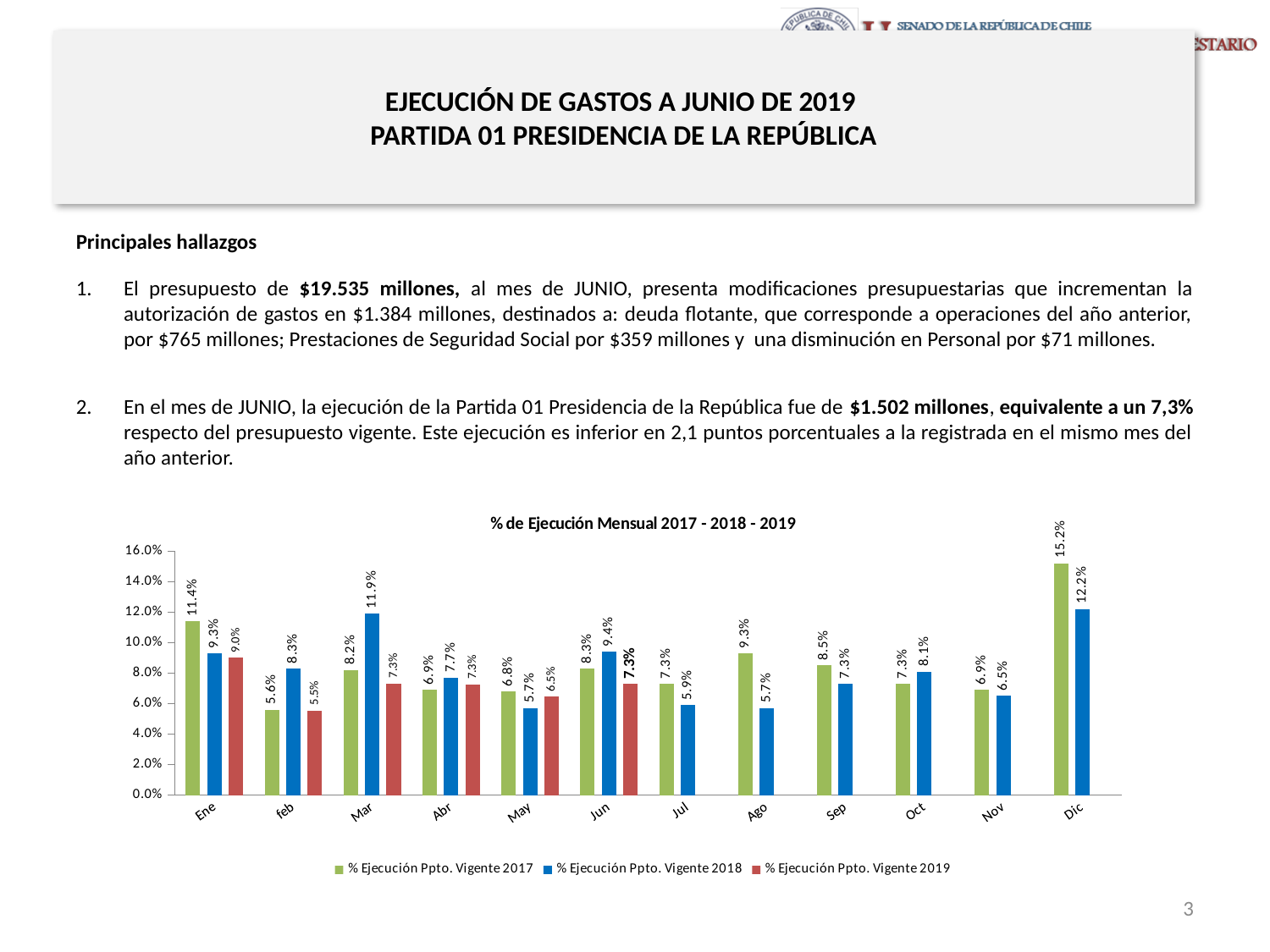
What is the value for % Ejecución Ppto. Vigente 2018 in Mar? 11.9% What is the difference between the 2017 and 2018 values in Ene? 2.1% How many months are shown on the x axis? 12 What is the value for % Ejecución Ppto. Vigente 2017 in Dic? 15.2% Is the value for % Ejecución Ppto. Vigente 2018 in Dic greater or less than 10.0%? greater What is the title of the chart? % de Ejecución Mensual 2017 - 2018 - 2019 What is the value for % Ejecución Ppto. Vigente 2019 in Jun? 7.3% What kind of chart is shown on the slide? Bar chart How many series does the legend list? 3 Which month has the highest value for % Ejecución Ppto. Vigente 2018? Dic Which month has the lowest value for % Ejecución Ppto. Vigente 2017? feb Which is larger in May: the 2017 value or the 2018 value? 2017 value (6.8%)